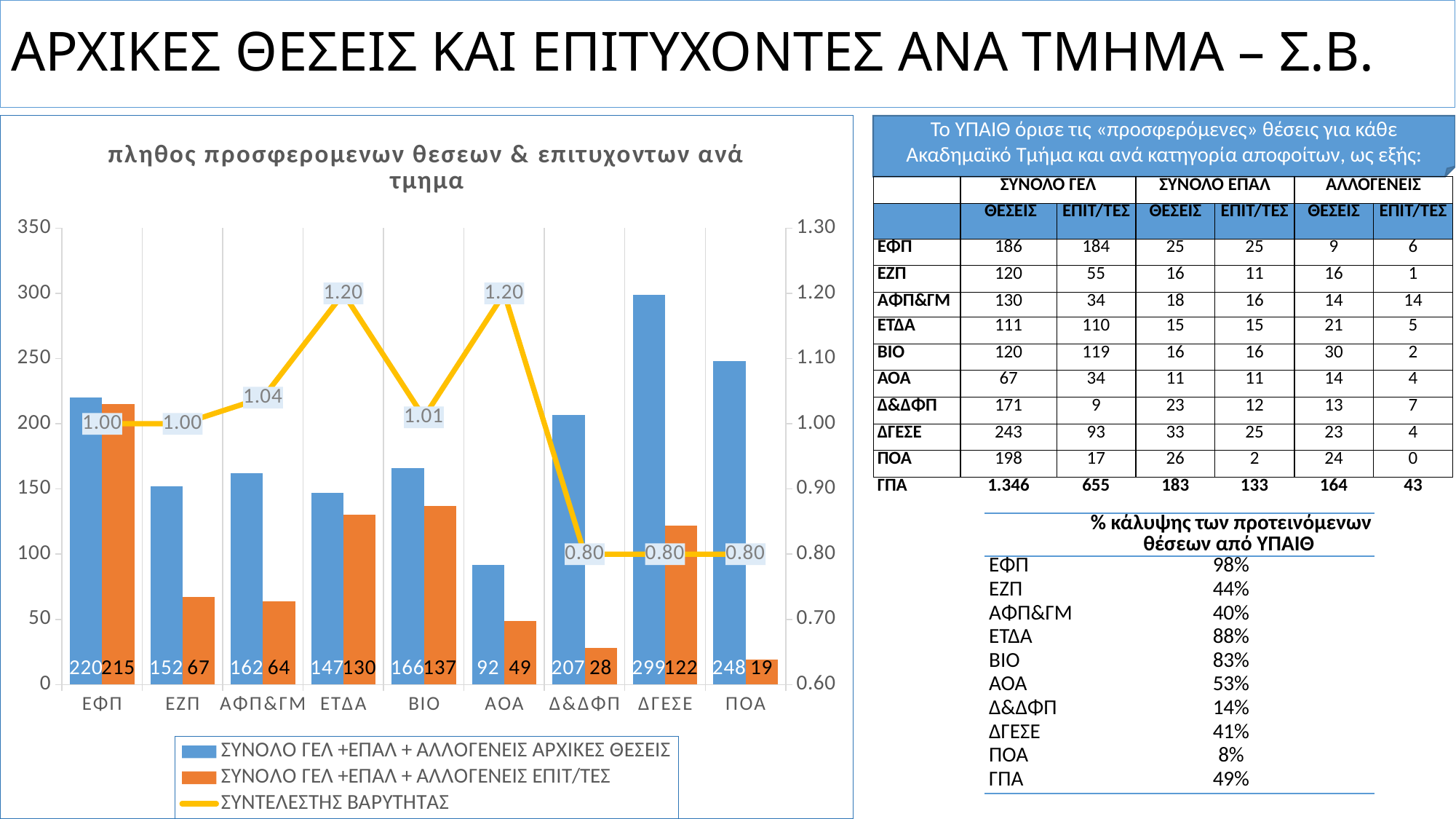
What is the ΣΥΝΤΕΛΕΣΤΗΣ ΒΑΡΥΤΗΤΑΣ value for ΑΦΠ&ΓΜ? 1.04 Does the ΣΥΝΤΕΛΕΣΤΗΣ ΒΑΡΥΤΗΤΑΣ line rise or fall from ΑΟΑ to Δ&ΔΦΠ? Fall What is the value of ΣΥΝΟΛΟ ΓΕΛ +ΕΠΑΛ + ΑΛΛΟΓΕΝΕΙΣ ΑΡΧΙΚΕΣ ΘΕΣΕΙΣ for ΔΓΕΣΕ? 299 What is the title of the chart? πληθος προσφερομενων θεσεων & επιτυχοντων ανά τμημα How many series does the chart legend list? 3 What is the difference between ΑΡΧΙΚΕΣ ΘΕΣΕΙΣ and ΕΠΙΤ/ΤΕΣ for ΕΦΠ? 5 Which is larger: the ΑΡΧΙΚΕΣ ΘΕΣΕΙΣ value for ΠΟΑ or for Δ&ΔΦΠ? ΠΟΑ What kind of chart is shown on the slide? Combined bar and line chart What is the value of ΣΥΝΟΛΟ ΓΕΛ +ΕΠΑΛ + ΑΛΛΟΓΕΝΕΙΣ ΕΠΙΤ/ΤΕΣ for ΒΙΟ? 137 Which category has the lowest ΣΥΝΟΛΟ ΓΕΛ +ΕΠΑΛ + ΑΛΛΟΓΕΝΕΙΣ ΕΠΙΤ/ΤΕΣ value? ΠΟΑ Which category has the highest ΣΥΝΟΛΟ ΓΕΛ +ΕΠΑΛ + ΑΛΛΟΓΕΝΕΙΣ ΑΡΧΙΚΕΣ ΘΕΣΕΙΣ value? ΔΓΕΣΕ How many categories are shown on the x axis of the chart? 9